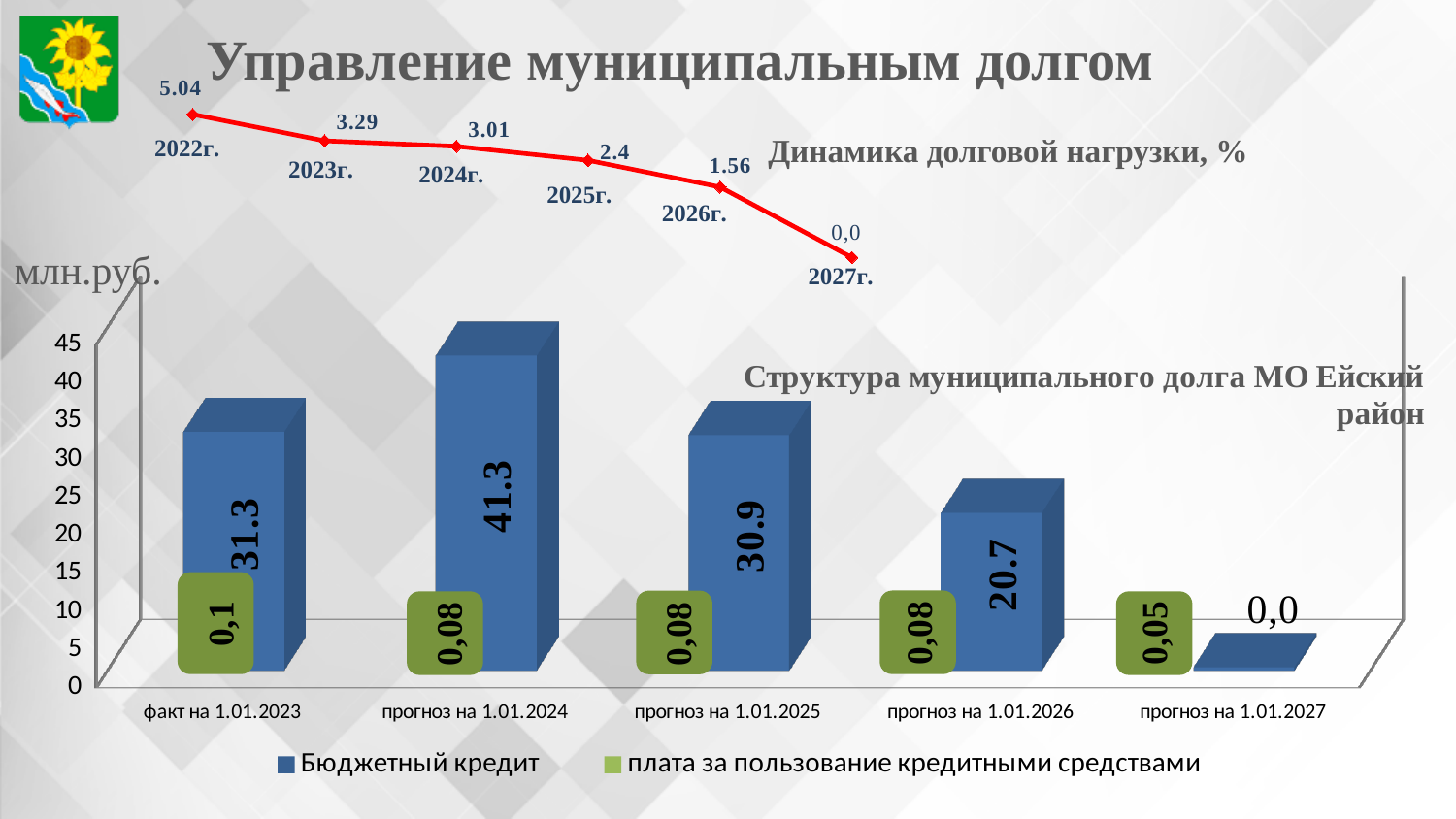
On the chart 'Структура муниципального долга МО Ейский район', what is the value of Бюджетный кредит for прогноз на 1.01.2024? 41.3 On the chart 'Динамика долговой нагрузки, %', do the values rise or fall from 2022г. to 2027г.? fall On the chart 'Динамика долговой нагрузки, %', what is the value for 2022г.? 5.04 On the chart 'Динамика долговой нагрузки, %', what is the value for 2026г.? 1.56 On the chart 'Динамика долговой нагрузки, %', how many years are plotted? 6 On the chart 'Структура муниципального долга МО Ейский район', what is the value of плата за пользование кредитными средствами for факт на 1.01.2023? 0,1 On the chart 'Структура муниципального долга МО Ейский район', what is the difference in Бюджетный кредит between прогноз на 1.01.2024 and прогноз на 1.01.2025? 10.4 What kind of chart is 'Структура муниципального долга МО Ейский район'? bar chart On the chart 'Структура муниципального долга МО Ейский район', which category has the lowest value of Бюджетный кредит? прогноз на 1.01.2027 On the chart 'Динамика долговой нагрузки, %', which year has the highest value? 2022г. On the chart 'Структура муниципального долга МО Ейский район', how many series does the legend list? 2 On the chart 'Динамика долговой нагрузки, %', what is the difference between the values for 2023г. and 2024г.? 0.28